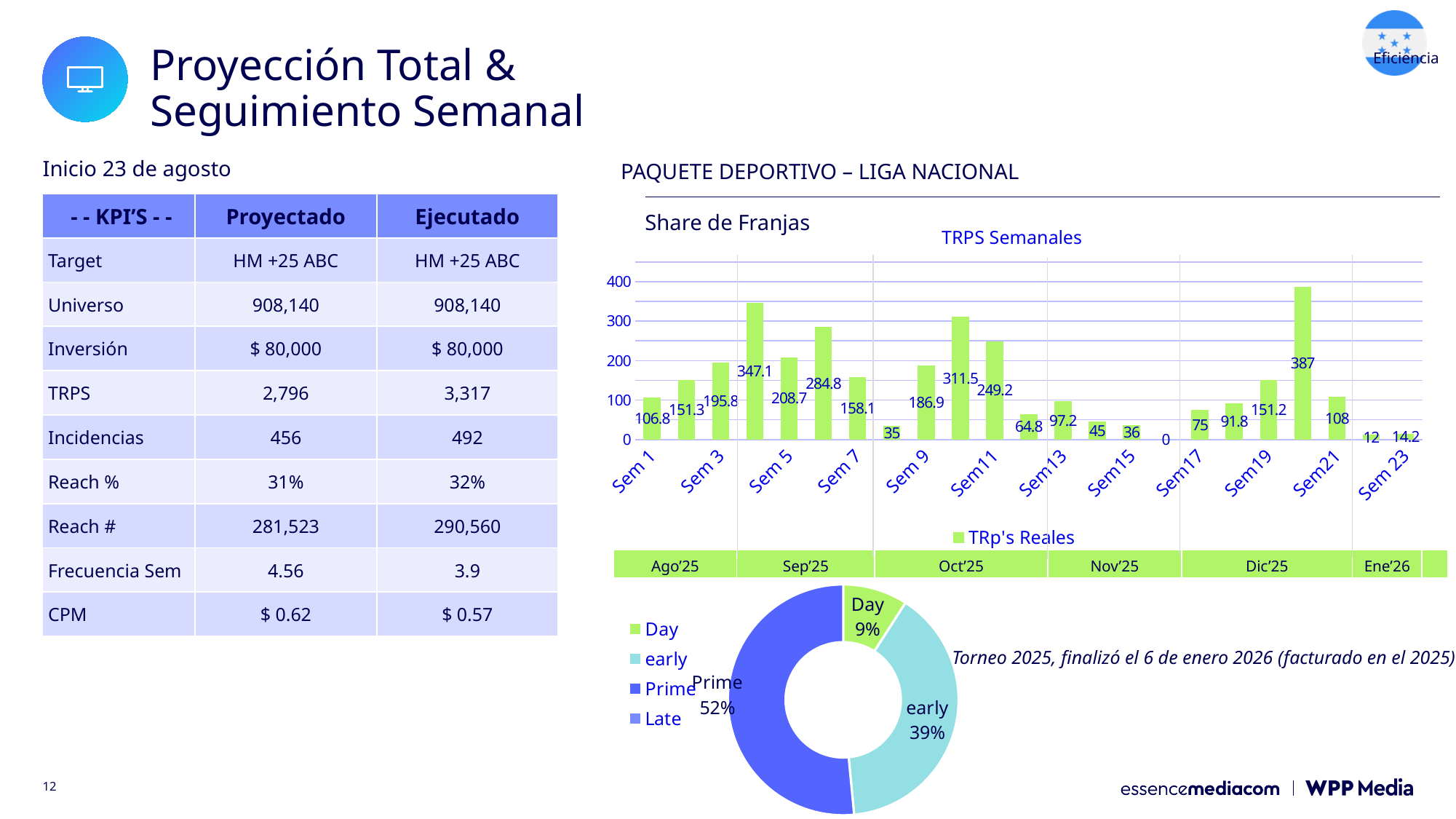
In the TRPS Semanales chart, what is the highest value shown on any bar? 387 In the TRPS Semanales chart, what is the value for Sem 9? 186.9 In the Share de Franjas chart, which category has the largest share? Prime In the TRPS Semanales chart, what is the value for Sem 1? 106.8 What kind of chart is the TRPS Semanales chart? Bar chart In the Share de Franjas chart, what share does Prime have? 52% In the TRPS Semanales chart, which has a larger value, Sem 3 or Sem19? Sem 3 What kind of chart is the Share de Franjas chart? Pie (doughnut) chart How many entries does the legend of the Share de Franjas chart list? 4 What series name is shown in the legend of the TRPS Semanales chart? TRp's Reales In the TRPS Semanales chart, what is the difference between the values for Sem 5 and Sem 7? 50.6 In the TRPS Semanales chart, what is the value for Sem 23? 14.2